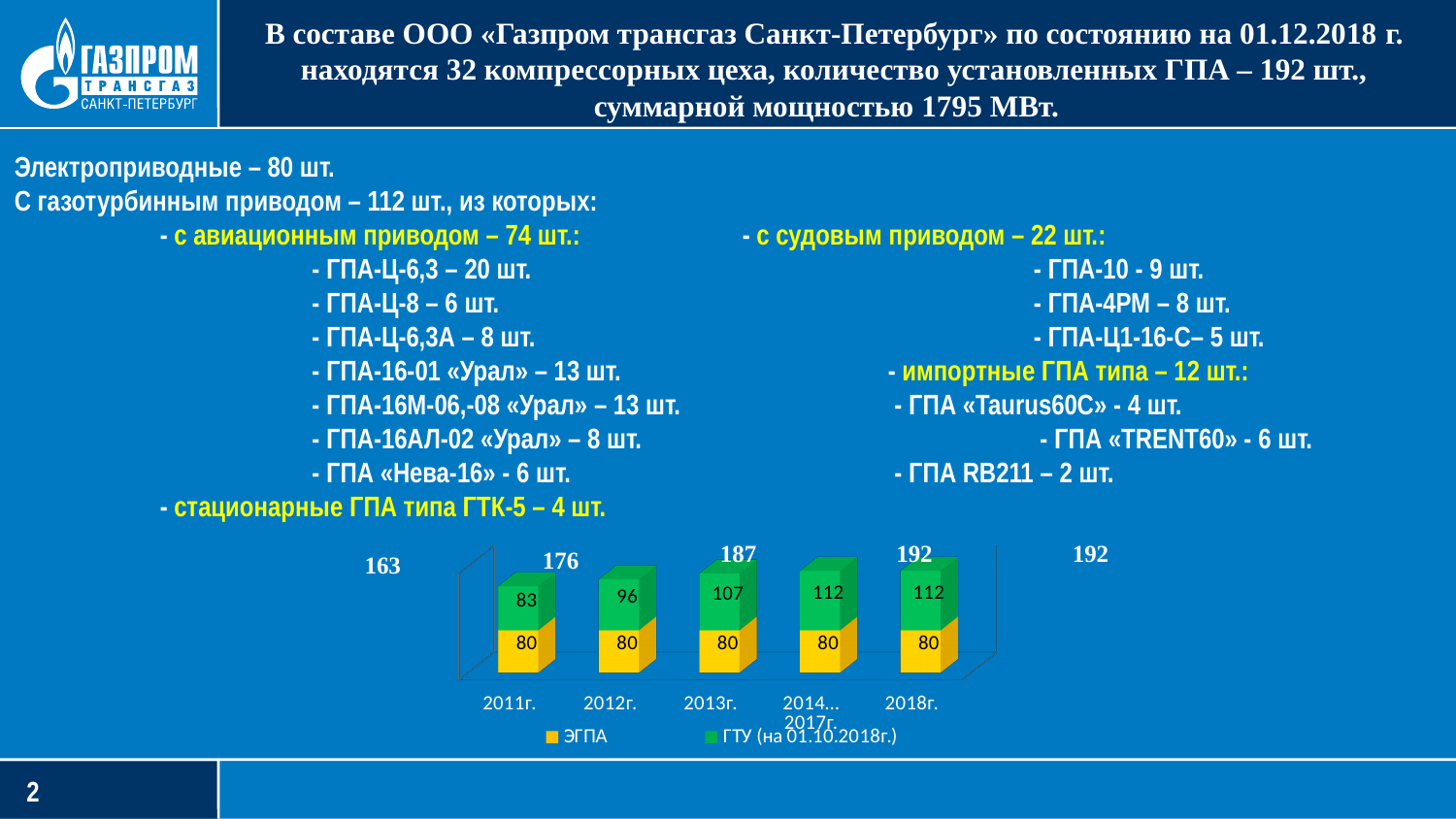
What is the ЭГПА value for 2012г.? 80 What is the total of the stacked bar for 2013г.? 187 What is the ГТУ value for 2011г.? 83 Which category has the lowest ГТУ value? 2011г. What is the total of the stacked bar for 2012г.? 176 Does the ГТУ series rise or fall from 2011г. to 2018г.? rise How many series does the chart legend list? 2 What kind of chart is shown at the bottom of the slide? stacked bar chart What is the difference between the ГТУ values for 2013г. and 2012г.? 11 What is the ГТУ value for 2013г.? 107 How many categories are shown on the x axis of the chart? 5 Is the ГТУ value larger for 2012г. or for 2013г.? 2013г.